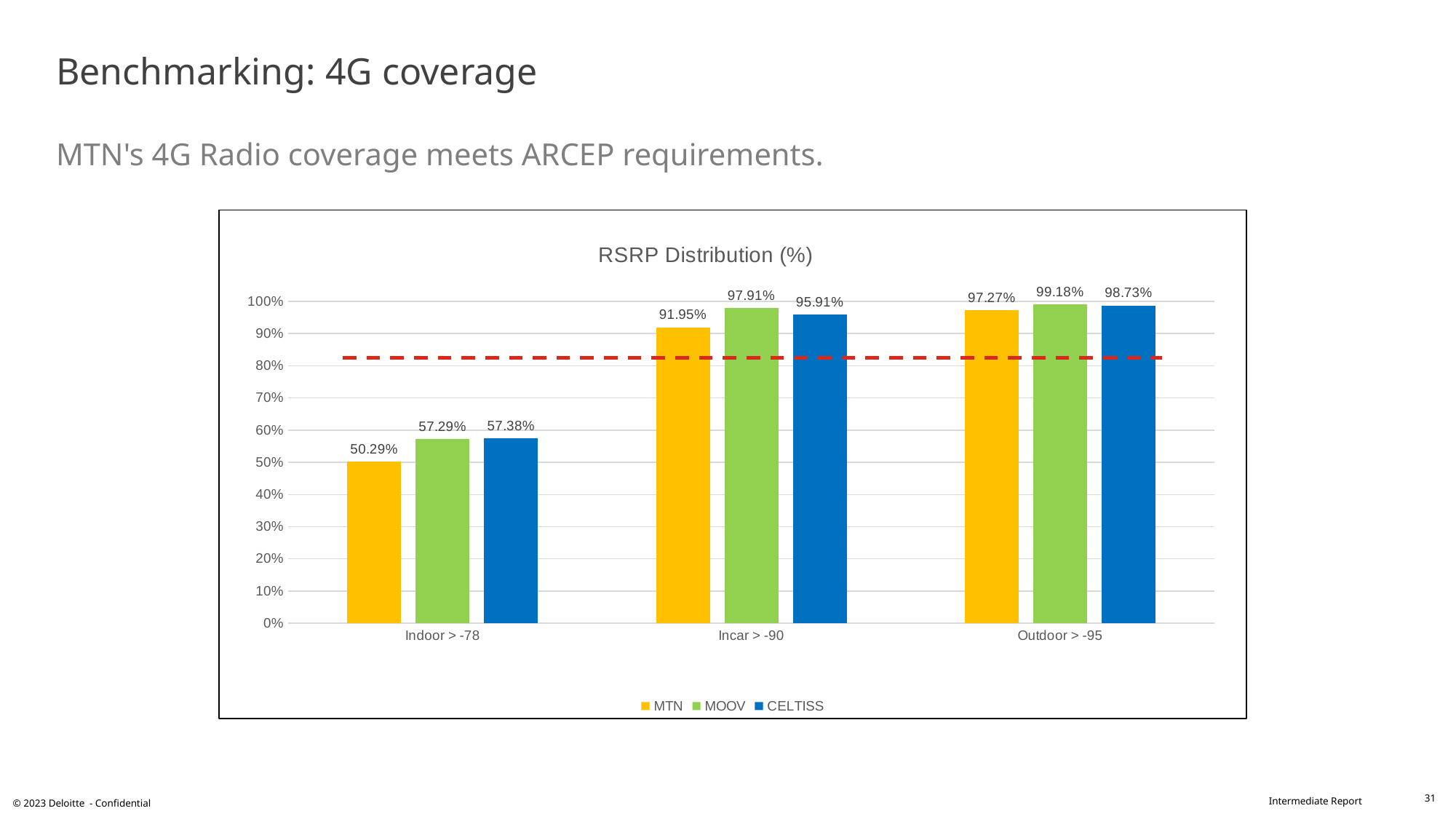
Which operator has the highest value in the Outdoor > -95 category? MOOV Is the value for MTN in the Indoor > -78 category greater or less than 60%? less Which operator has the lowest value in the Indoor > -78 category? MTN What kind of chart is shown on the slide? Bar chart Which is larger in the Incar > -90 category: MTN or CELTISS? CELTISS What is the title of the chart? RSRP Distribution (%) What is the difference between MOOV and MTN in the Incar > -90 category? 5.96% What is the value for MTN in the Indoor > -78 category? 50.29% What is the value for MOOV in the Outdoor > -95 category? 99.18% How many categories are shown on the x axis? 3 How many series does the legend list? 3 What is the value for CELTISS in the Incar > -90 category? 95.91%